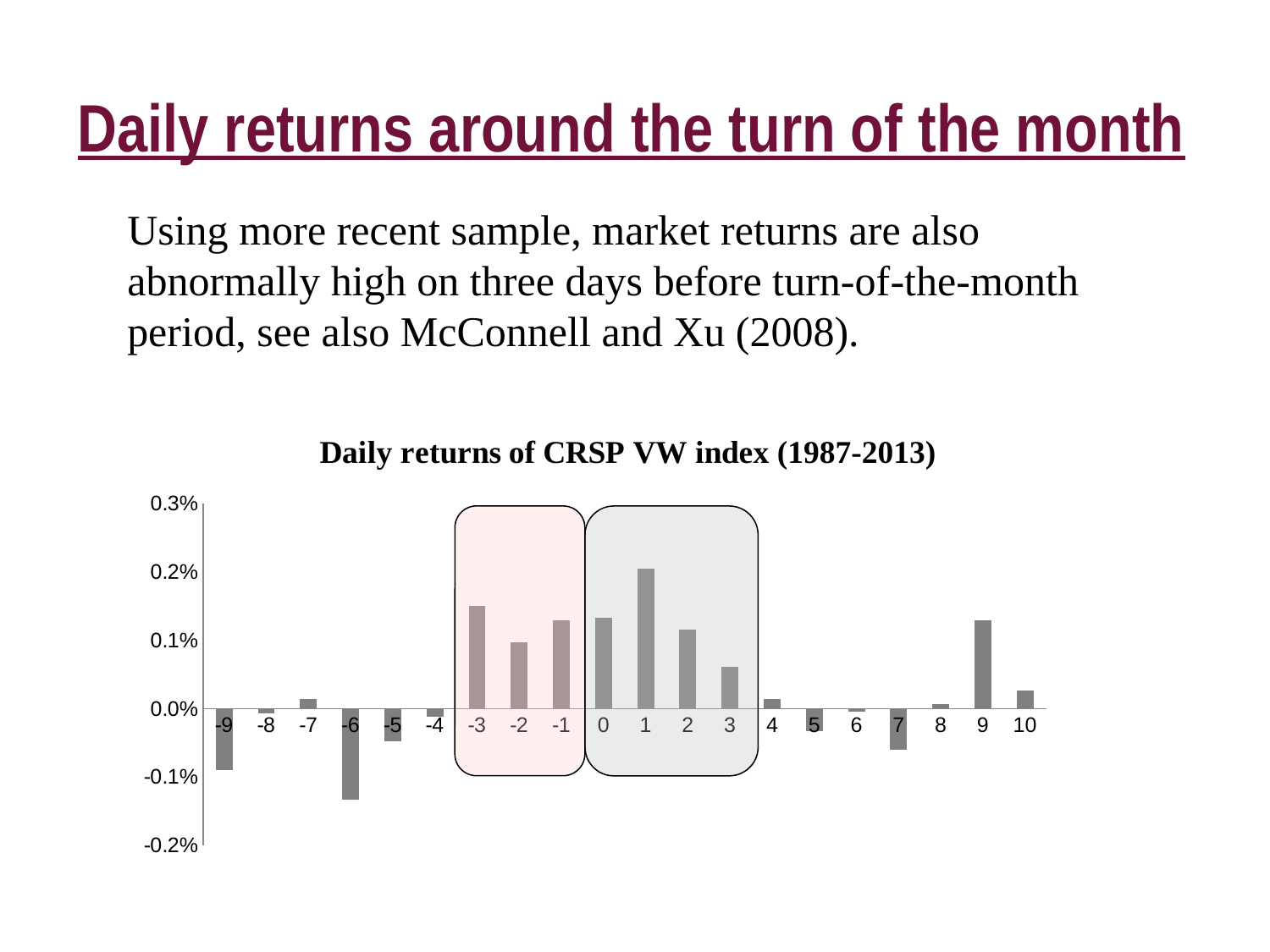
What kind of chart is shown on the slide? Bar chart Which has the larger daily return, day 1 or day -3? Day 1 Is the value for day -3 greater or less than 0.1%? greater Is the value for day -6 greater or less than -0.1%? less Which day has the lowest daily return? -6 Which has the larger daily return, day 9 or day 10? Day 9 Is the value for day 3 greater or less than 0.1%? less What is the title of the chart? Daily returns of CRSP VW index (1987-2013) How many days (categories) are plotted along the x axis? 20 Which day has the highest daily return? 1